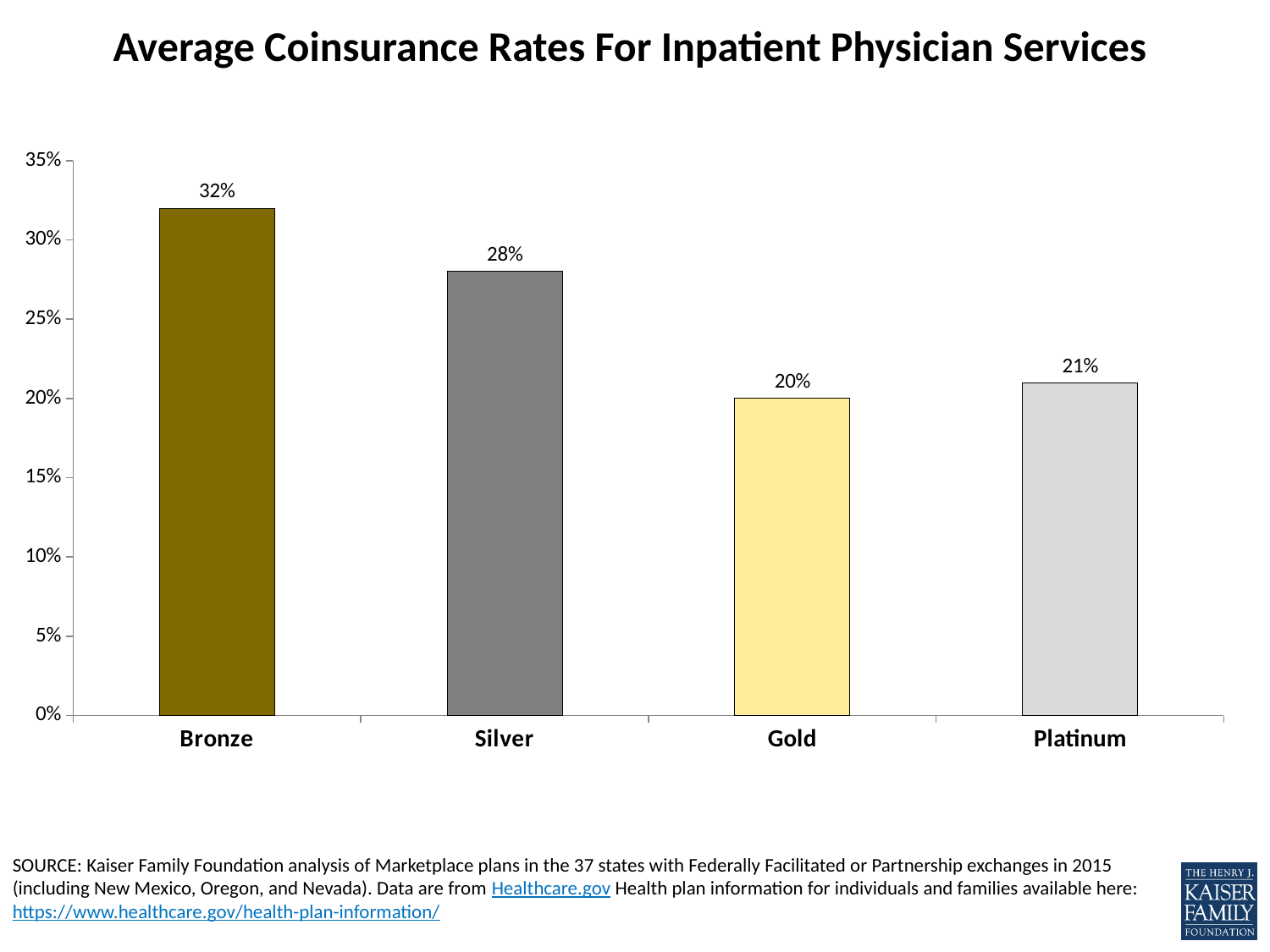
Which has a higher average coinsurance rate, Silver or Platinum? Silver What is the difference between the Bronze and Silver average coinsurance rates? 4 percentage points What is the title of the chart? Average Coinsurance Rates For Inpatient Physician Services What is the average coinsurance rate for Gold plans? 20% Which plan tier has the lowest average coinsurance rate? Gold What is the average coinsurance rate for Silver plans? 28% What is the average coinsurance rate for Bronze plans? 32% What type of chart is shown on the slide? Bar chart What is the average coinsurance rate for Platinum plans? 21% What is the difference between the Bronze and Gold average coinsurance rates? 12 percentage points How many plan tiers are shown in the chart? 4 Which plan tier has the highest average coinsurance rate? Bronze